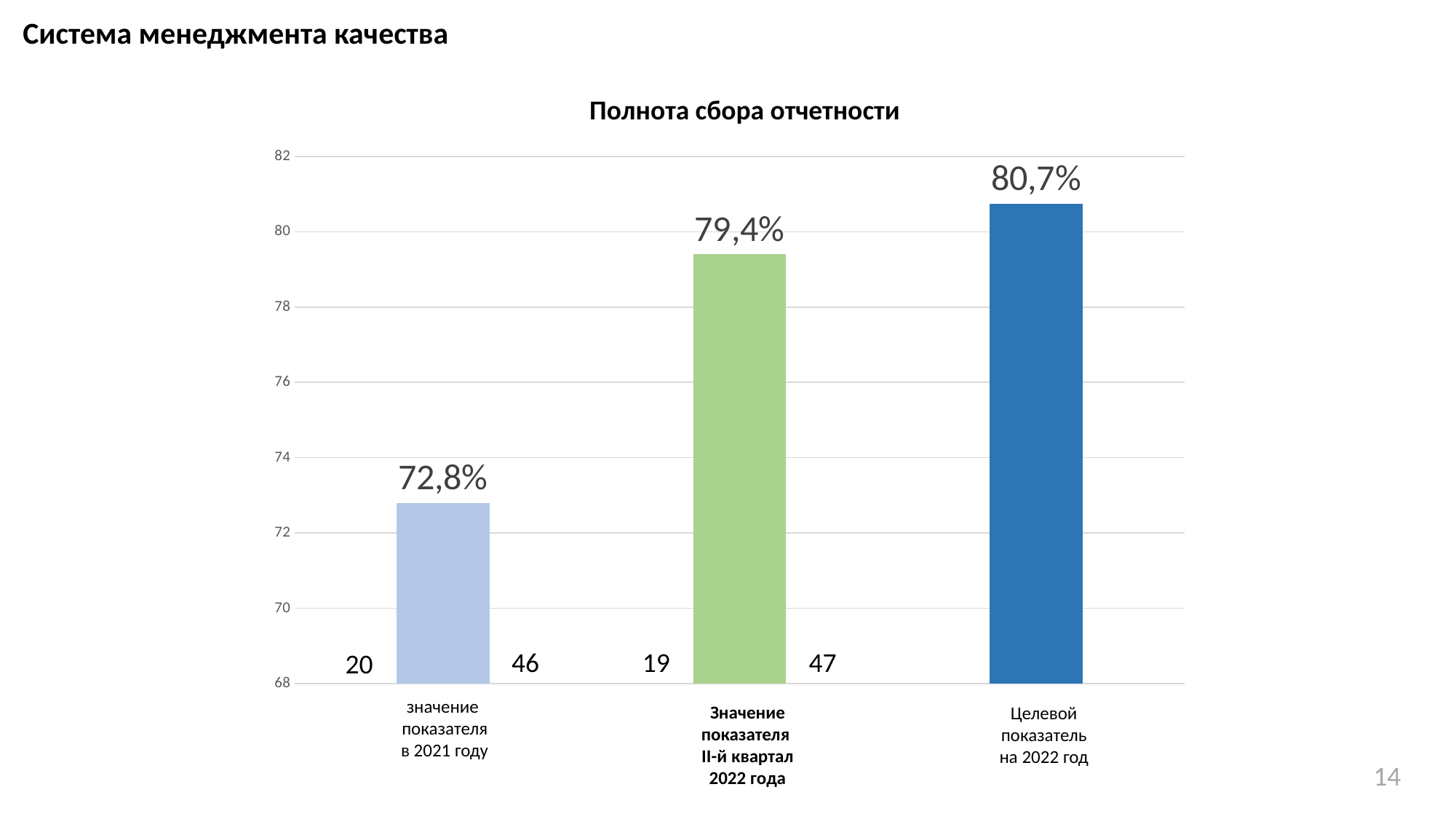
What kind of chart is shown on the slide? bar chart What is the difference between the II quarter 2022 value and the 2021 value? 6,6% Which category has the highest value? Целевой показатель на 2022 год What is the difference between the target for 2022 (Целевой показатель на 2022 год) and the 2021 value (значение показателя в 2021 году)? 7,9% Is the value for 'значение показателя в 2021 году' greater or less than 74? less What is the title of the chart? Полнота сбора отчетности What is the value for 'Значение показателя II-й квартал 2022 года'? 79,4% How many bars are shown in the chart? 3 What is the value for 'Целевой показатель на 2022 год'? 80,7% What is the value for 'значение показателя в 2021 году'? 72,8% Which category has the lowest value? значение показателя в 2021 году Which is larger: the value for II-й квартал 2022 года or the value for 2021 году? II-й квартал 2022 года